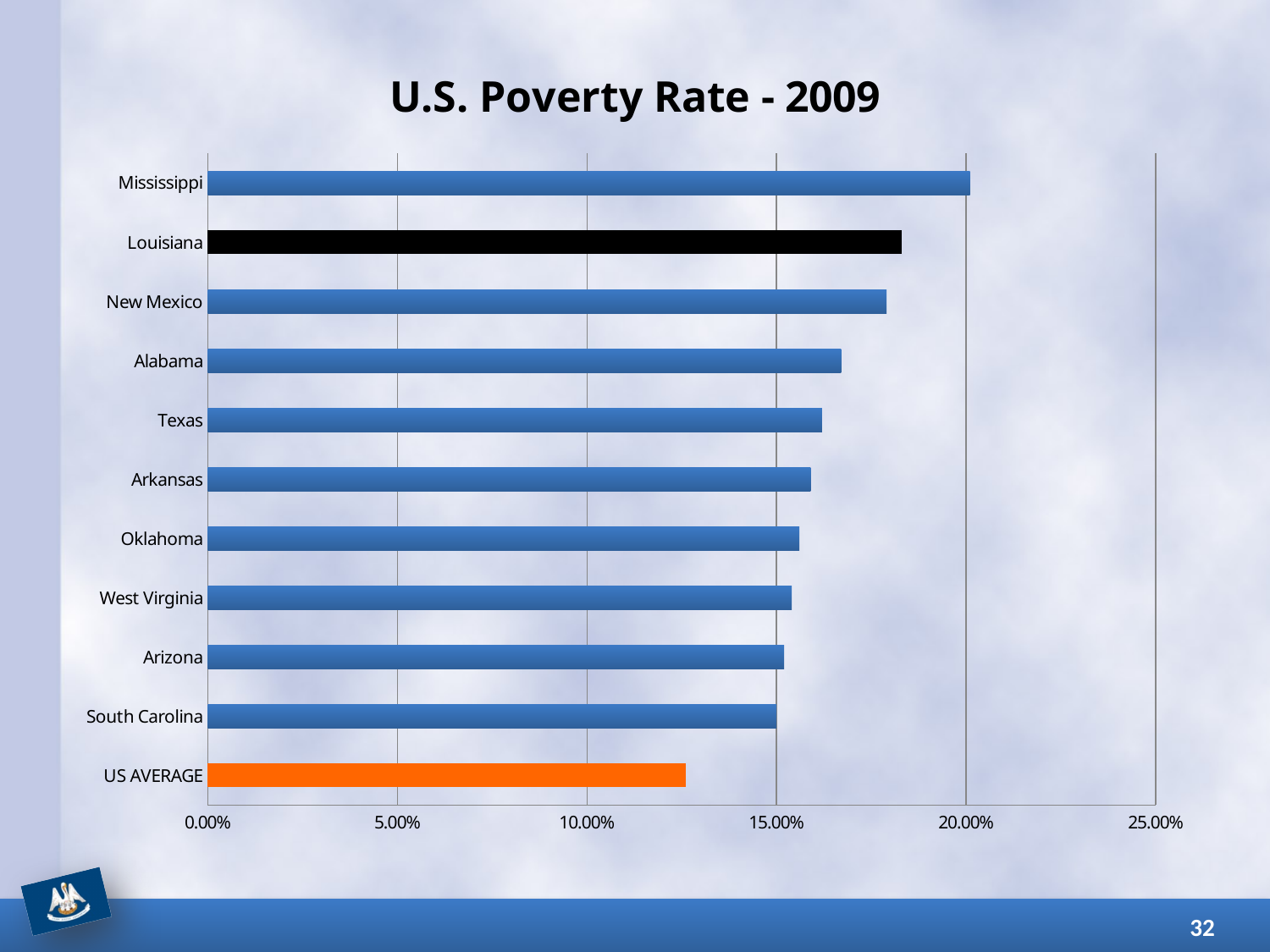
What is the title of the chart? U.S. Poverty Rate - 2009 Is the value for Oklahoma greater or less than 15.00%? greater What kind of chart is shown on the slide? bar chart What colour is the bar for Louisiana? black Which has a higher value, Texas or US AVERAGE? Texas Is the value for Louisiana greater or less than 20.00%? less How many categories (bars) are shown in the chart? 11 Which has a higher poverty rate, Louisiana or Alabama? Louisiana Which category has the highest poverty rate in the chart? Mississippi Which category has the lowest value in the chart? US AVERAGE Is the value for Alabama greater or less than 15.00%? greater